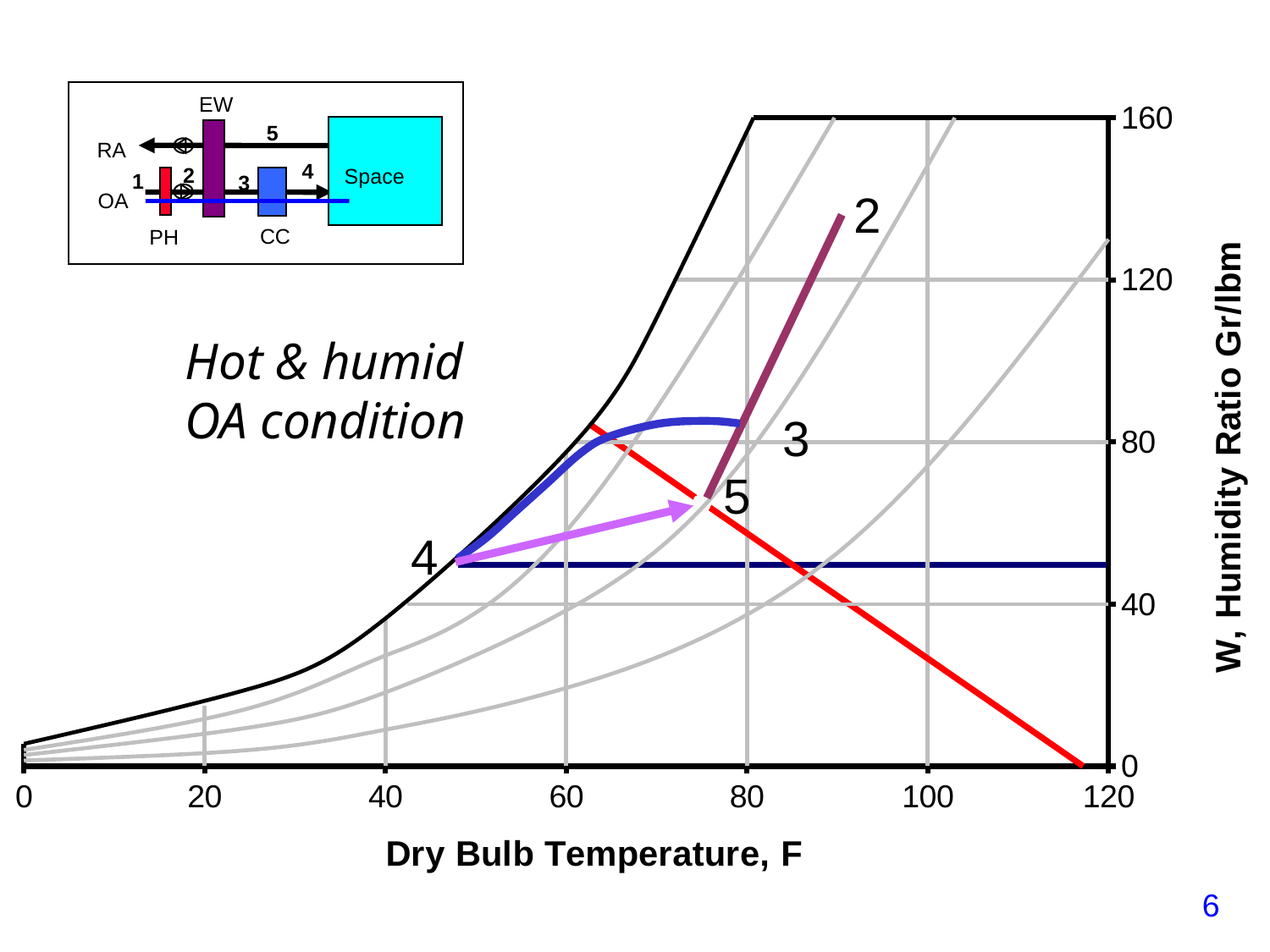
What is the highest value shown on the humidity ratio axis? 160 What is the title of the y axis of the chart? W, Humidity Ratio Gr/lbm Is the dry bulb temperature at point 2 greater or less than 80? greater Is the humidity ratio at point 2 greater or less than 120? greater What is the title of the x axis of the chart? Dry Bulb Temperature, F Does the red line rise or fall as dry bulb temperature increases? Falls What is the highest dry bulb temperature shown on the x axis? 120 Is the dry bulb temperature at point 4 greater or less than 60? less Which point has the higher humidity ratio, point 2 or point 4? Point 2 How many numbered state points are labeled on the chart? 4